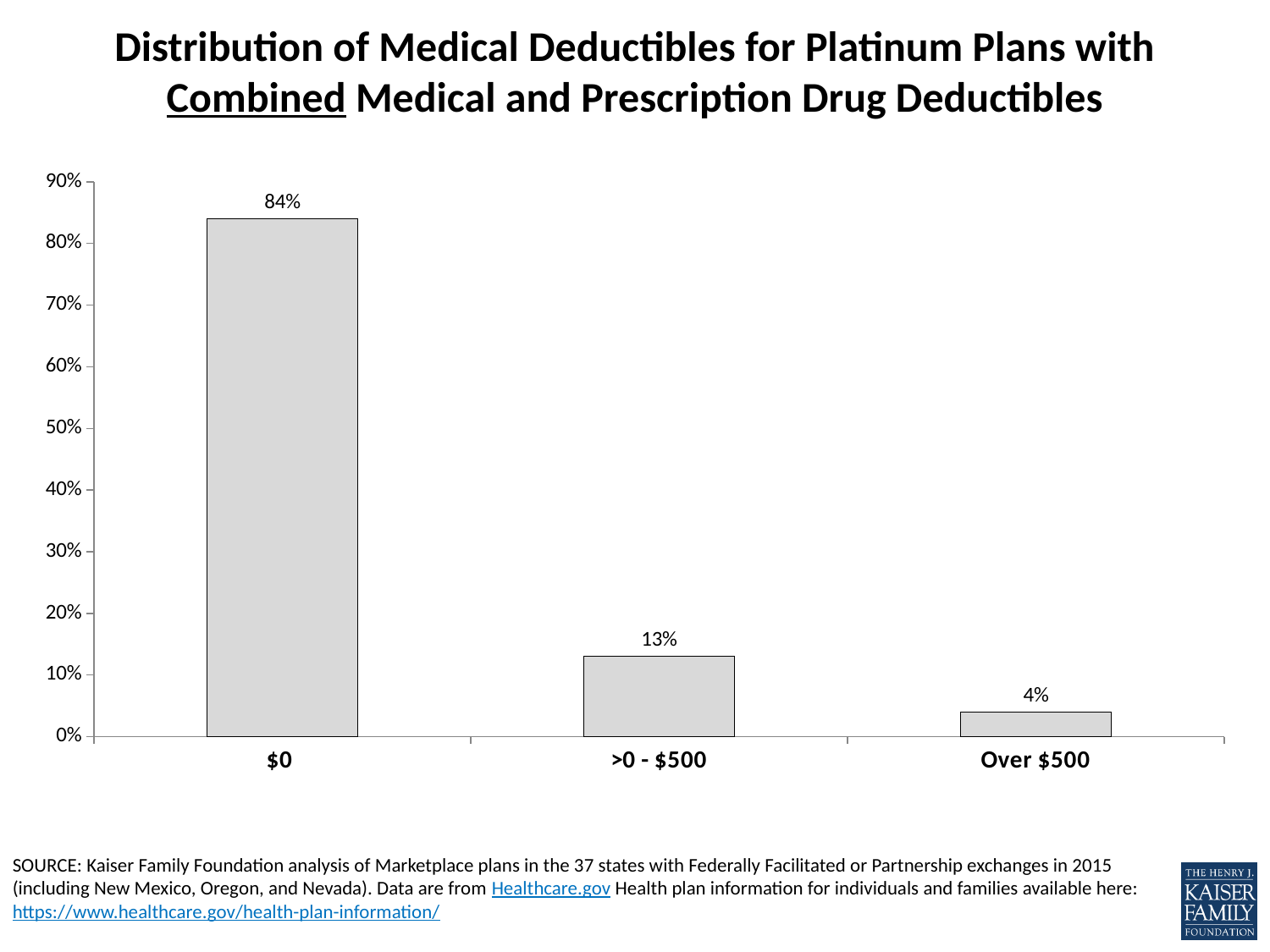
How many deductible categories are shown on the x axis? 3 Which deductible category has the lowest percentage of plans? Over $500 What type of chart is shown on the slide? Bar chart What percentage of platinum plans with combined deductibles have a $0 medical deductible? 84% What is the difference between the >0 - $500 value and the Over $500 value? 9 Which is larger, the value for >0 - $500 or the value for Over $500? >0 - $500 Is the value for $0 greater or less than 80%? greater What is the value for the >0 - $500 category? 13% What is the difference in percentage points between the $0 category and the >0 - $500 category? 71 What share of plans have a medical deductible over $500? 4% Do the values rise or fall moving from left to right along the x axis? Fall Which deductible category has the highest percentage of plans? $0